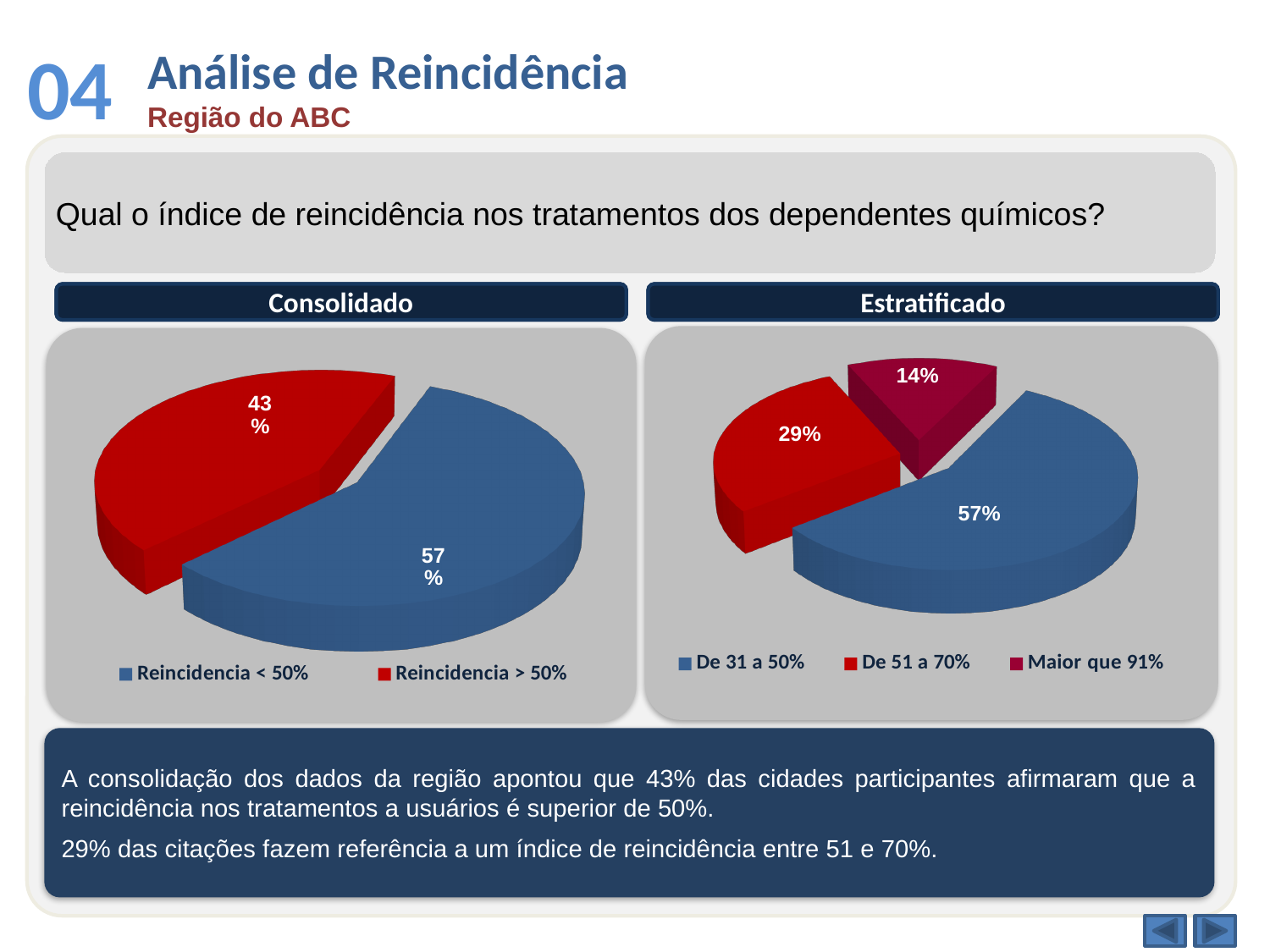
In the Consolidado chart, what is the value for Reincidencia < 50%? 57% In the Consolidado chart, which is larger: Reincidencia < 50% or Reincidencia > 50%? Reincidencia < 50% In the Consolidado chart, what is the value for Reincidencia > 50%? 43% In the Estratificado chart, which category has the largest slice? De 31 a 50% In the Estratificado chart, what is the difference between De 31 a 50% and De 51 a 70%? 28% How many categories does the Estratificado chart show? 3 In the Estratificado chart, what is the value for De 51 a 70%? 29% In the Estratificado chart, which category has the smallest slice? Maior que 91% In the Consolidado chart, what is the difference between Reincidencia < 50% and Reincidencia > 50%? 14% In the Estratificado chart, what is the value for Maior que 91%? 14% In the Estratificado chart, what colour is the slice for Maior que 91%? Dark magenta What kind of chart is the Consolidado chart? Pie chart